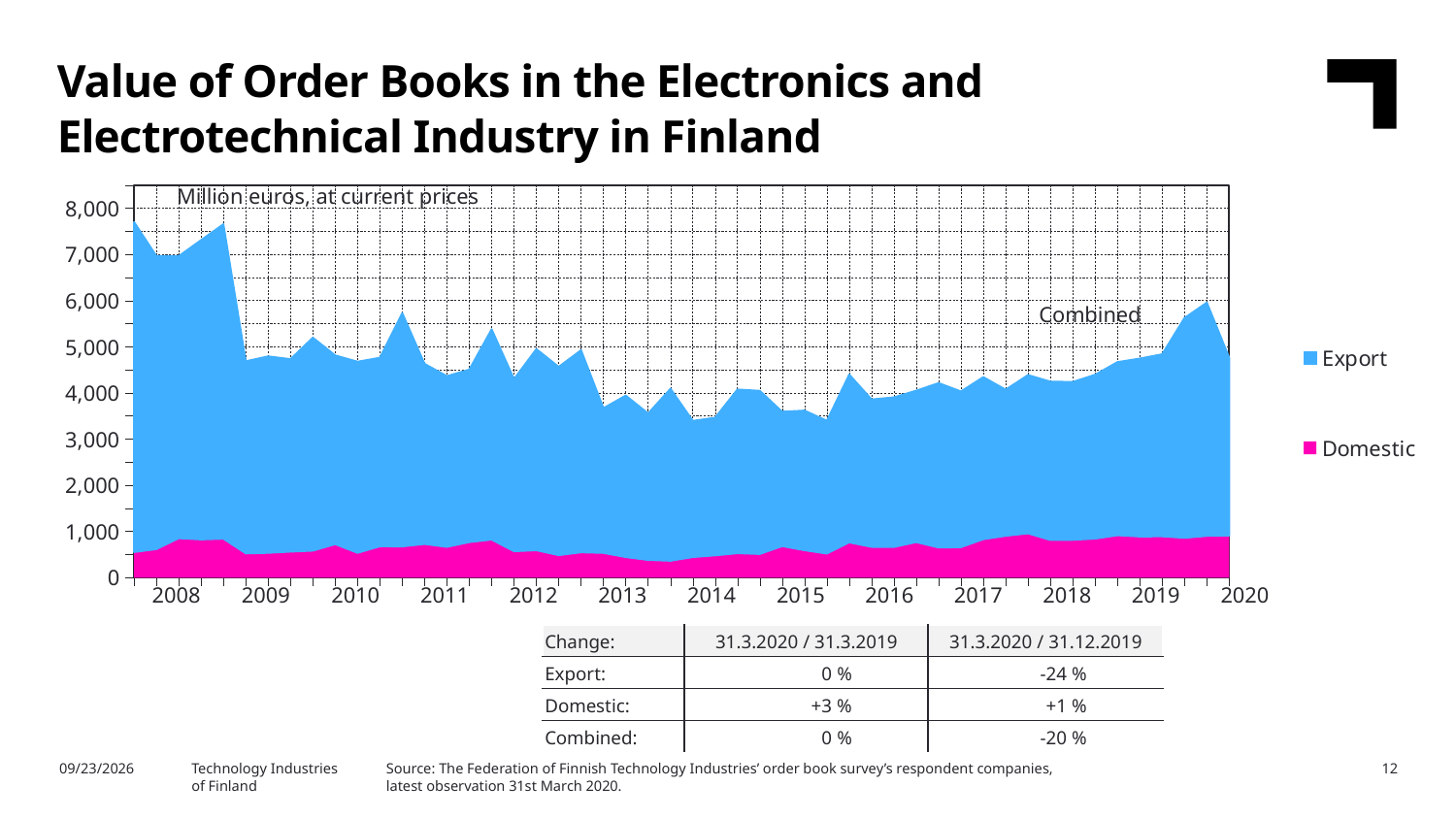
Which series is larger throughout the chart, Export or Domestic? Export What unit label is printed at the top of the chart? Million euros, at current prices What kind of chart is shown on the slide? Area chart Does the combined value of order books rise or fall between 2008 and 2009? Fall Is the combined value of order books in 2014 greater or less than 5,000? less Does the combined value of order books rise or fall between 2016 and 2019? Rise How many series does the legend list? 2 What are the two series named in the legend? Export and Domestic Is the Domestic value in 2008 greater or less than 1,000? less Is the combined value at its late-2019 peak greater or less than 5,000? greater How many year labels are shown on the x axis? 13